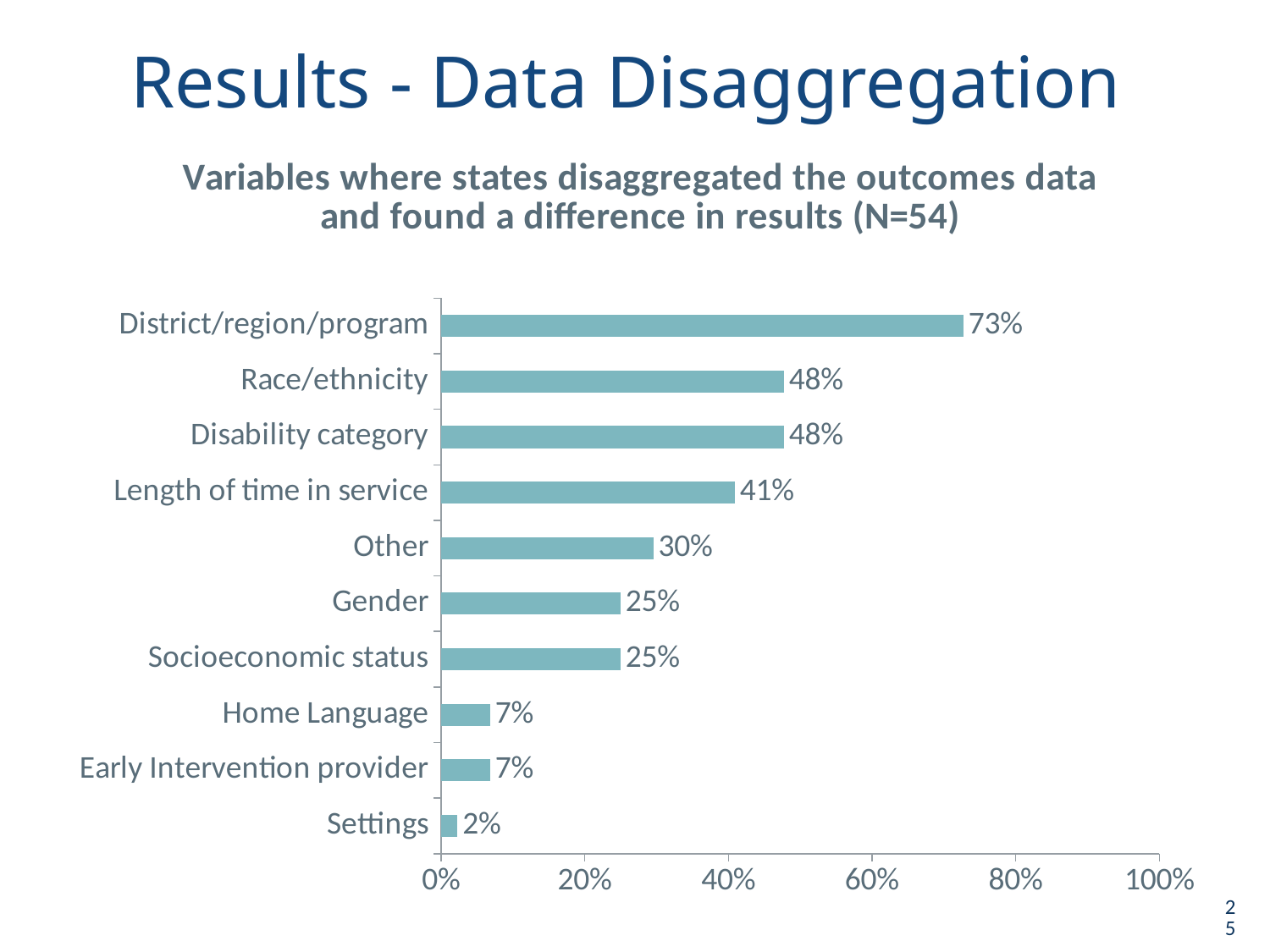
What is the value for District/region/program? 73% What is the difference between the values for Other and Gender? 5% Is the value for Disability category greater or less than 40%? greater What kind of chart is shown on the slide? Bar chart What is the value for Length of time in service? 41% What is the difference between the values for District/region/program and Race/ethnicity? 25% How many categories are shown in the chart? 10 Which is larger, the value for Length of time in service or the value for Other? Length of time in service What is the value for Home Language? 7% Which category has the lowest value? Settings Which category has the highest value? District/region/program What is the title of the chart? Variables where states disaggregated the outcomes data and found a difference in results (N=54)